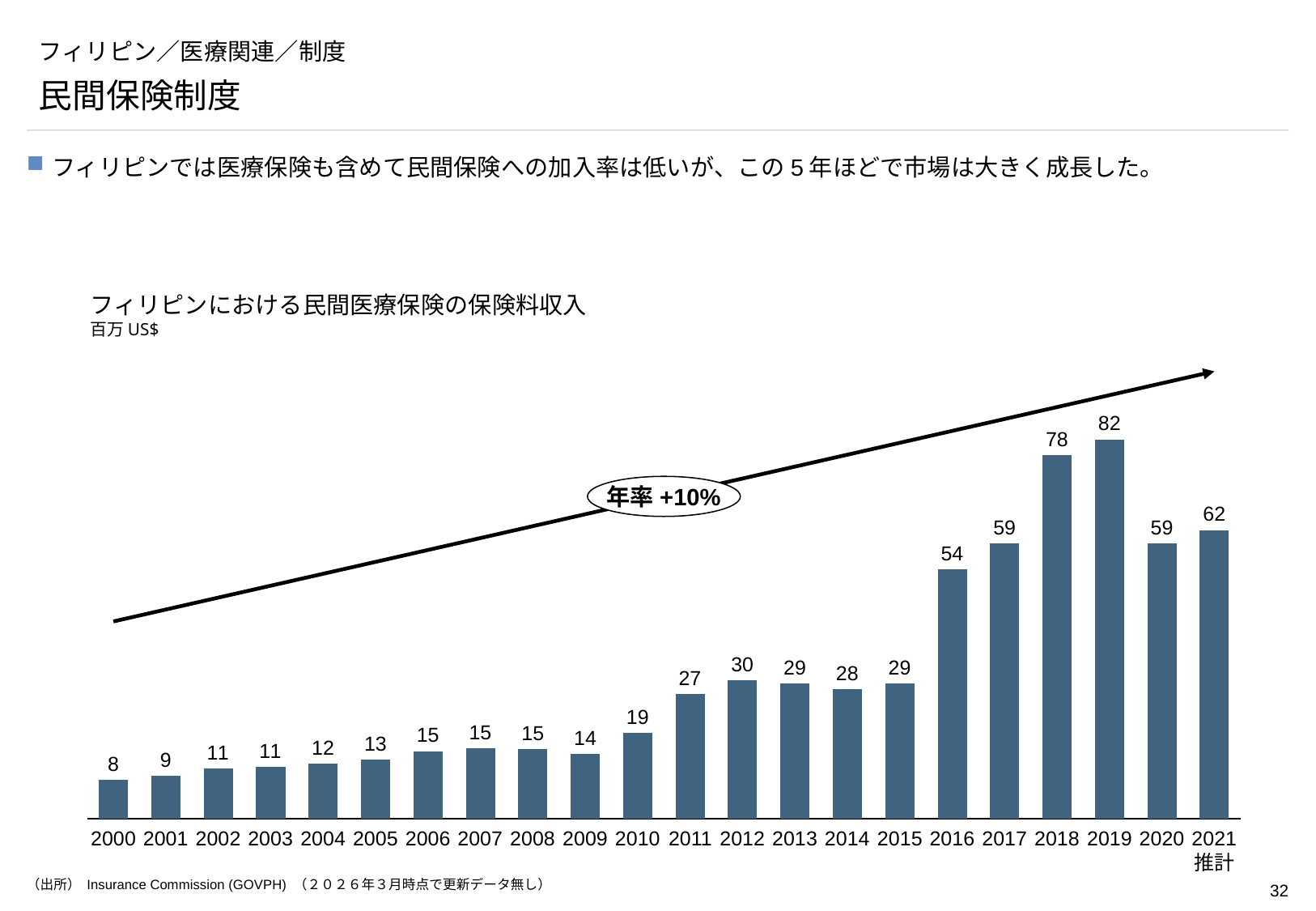
What is the value for 2021 推計? 62 How many years are shown on the x axis? 22 What kind of chart is this? bar chart What is the value for 2010? 19 What unit is stated under the chart title? 百万 US$ Which year has the highest value? 2019 Which is larger, the value for 2016 or the value for 2015? 2016 Which year has the lowest value? 2000 What annual growth rate is shown in the oval label on the chart? 年率 +10% What is the value for 2019? 82 Do the values generally rise or fall from 2000 to 2019? rise What is the difference between the values for 2019 and 2020? 23